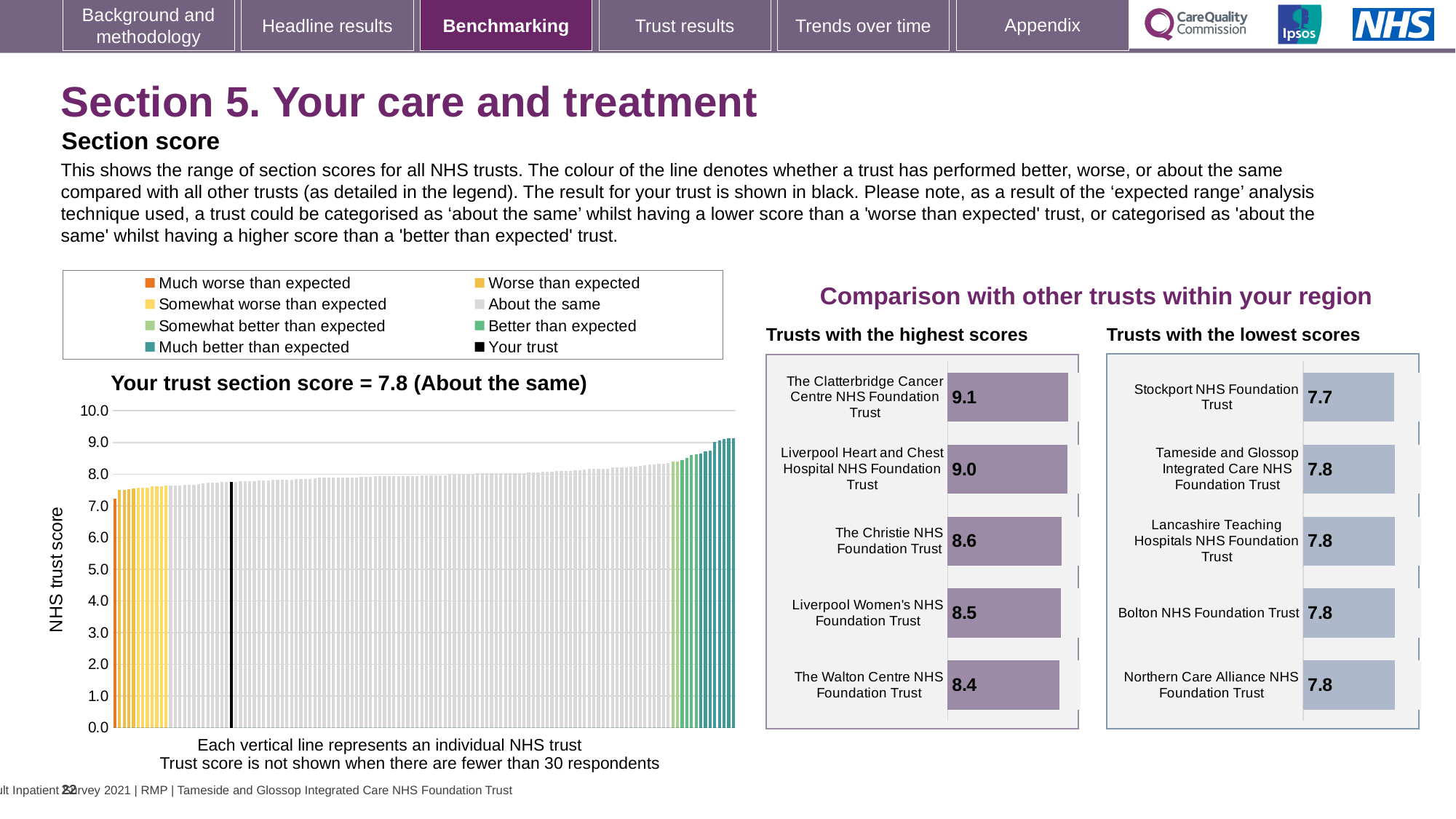
In the 'Trusts with the highest scores' chart, which trust has the lowest score? The Walton Centre NHS Foundation Trust In the 'Trusts with the highest scores' chart, what is the score for The Clatterbridge Cancer Centre NHS Foundation Trust? 9.1 In the 'Trusts with the lowest scores' chart, what is the score for Stockport NHS Foundation Trust? 7.7 In the 'Trusts with the highest scores' chart, what is the difference between the scores of The Clatterbridge Cancer Centre NHS Foundation Trust and The Walton Centre NHS Foundation Trust? 0.7 In the main section score chart on the left, is the lowest trust score greater or less than 8.0? less In the 'Trusts with the highest scores' chart, which trust has the highest score? The Clatterbridge Cancer Centre NHS Foundation Trust How many entries does the legend of the main section score chart on the left list? 8 How many trusts are shown in the 'Trusts with the lowest scores' chart? 5 In the 'Trusts with the highest scores' chart, what is the score for The Christie NHS Foundation Trust? 8.6 In the main section score chart on the left, what is the section score for your trust? 7.8 In the 'Trusts with the highest scores' chart, which has the larger score: Liverpool Heart and Chest Hospital NHS Foundation Trust or Liverpool Women's NHS Foundation Trust? Liverpool Heart and Chest Hospital NHS Foundation Trust In the 'Trusts with the lowest scores' chart, which trust has the lowest score? Stockport NHS Foundation Trust